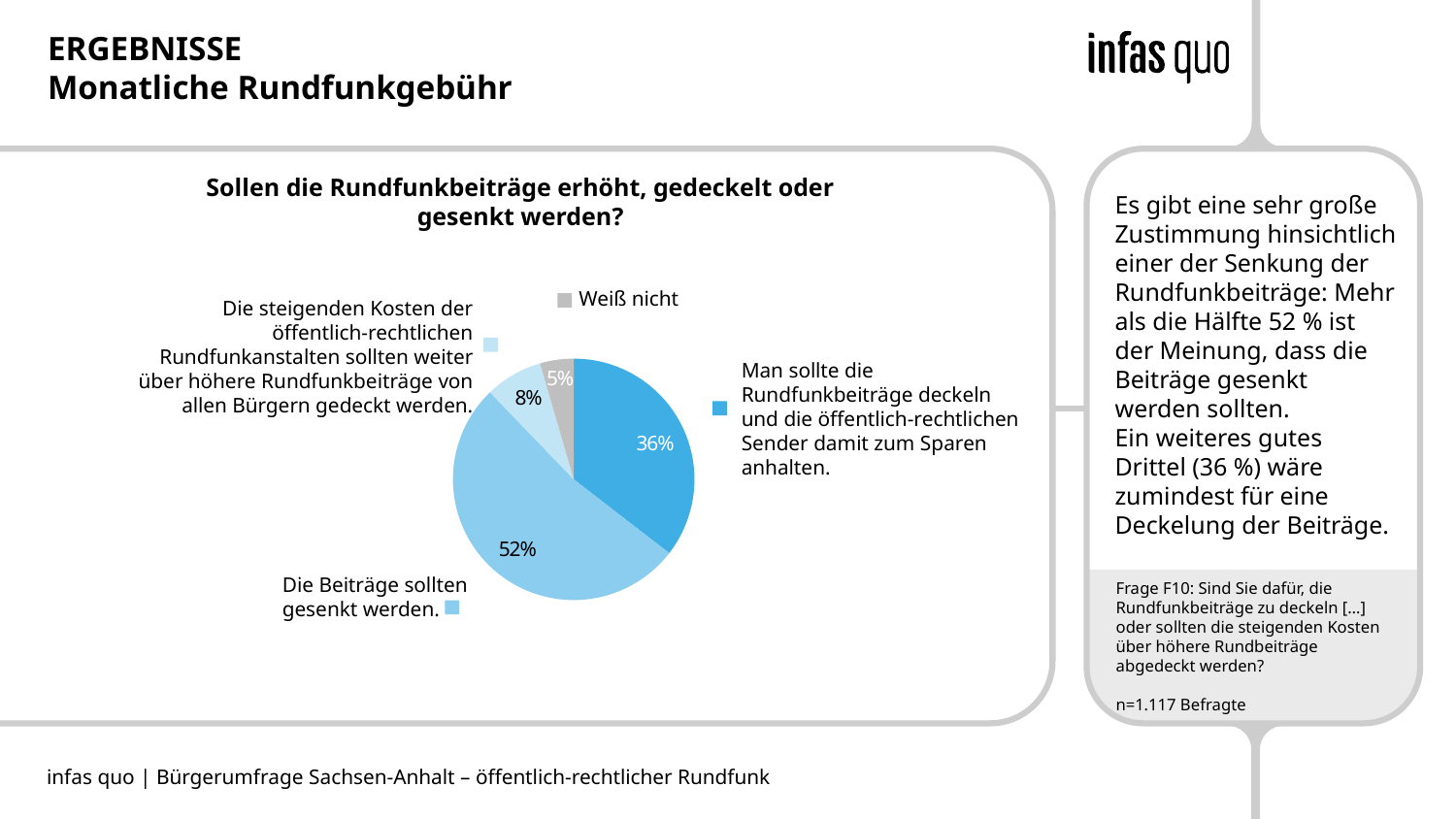
What share of respondents answered "Weiß nicht"? 5% Which is larger: the share for covering costs through higher contributions or the share for "Weiß nicht"? higher contributions (8%) How many slices does the pie chart have? 4 Which answer option has the largest share of the pie? Die Beiträge sollten gesenkt werden. What is the question shown as the title above the pie chart? Sollen die Rundfunkbeiträge erhöht, gedeckelt oder gesenkt werden? What share of respondents say the contributions should be capped and the public broadcasters made to save? 36% What share of respondents say the contributions should be lowered ("Die Beiträge sollten gesenkt werden")? 52% What kind of chart is shown on the slide? pie chart What is the difference in percentage points between the "gesenkt werden" slice and the "deckeln" slice? 16 percentage points What share of respondents say the rising costs should continue to be covered by higher contributions from all citizens? 8% What is the combined share of the "gesenkt werden" and "deckeln" slices? 88% Which answer option has the smallest share of the pie? Weiß nicht